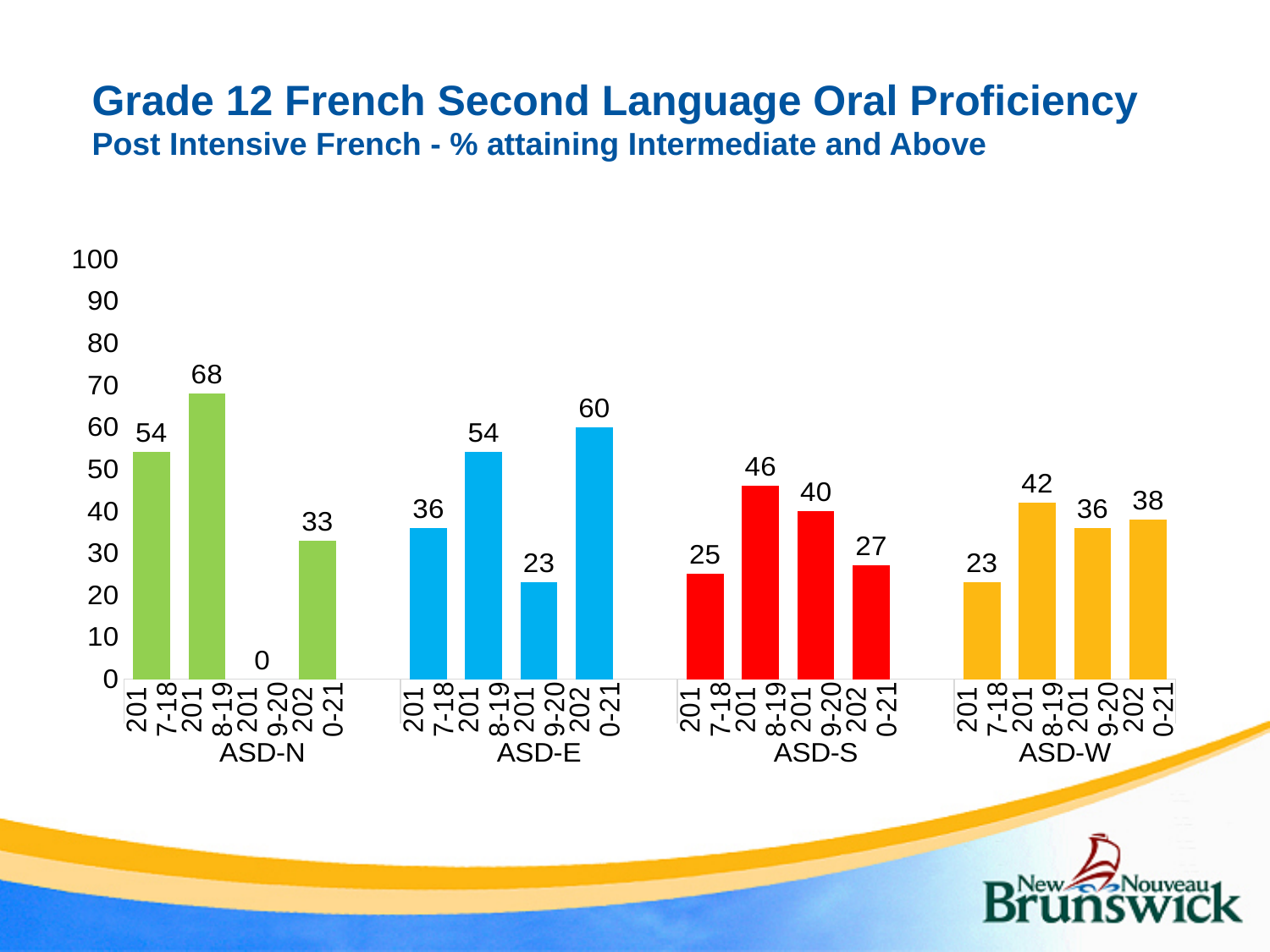
What colour are the bars for ASD-S? Red How many bars are plotted on the chart in total? 16 Which is larger: the ASD-S value for 2018-19 or the ASD-W value for 2018-19? ASD-S 2018-19 How many districts are shown on the x axis? 4 What is the value for ASD-W in 2017-18? 23 What is the value for ASD-S in 2019-20? 40 What is the value for ASD-E in 2020-21? 60 Which district and year has the highest value on the chart? ASD-N, 2018-19 What is the difference between the ASD-E values for 2020-21 and 2019-20? 37 What kind of chart is shown on the slide? Bar chart Which district and year has the lowest value on the chart? ASD-N, 2019-20 What is the value for ASD-N in 2018-19? 68